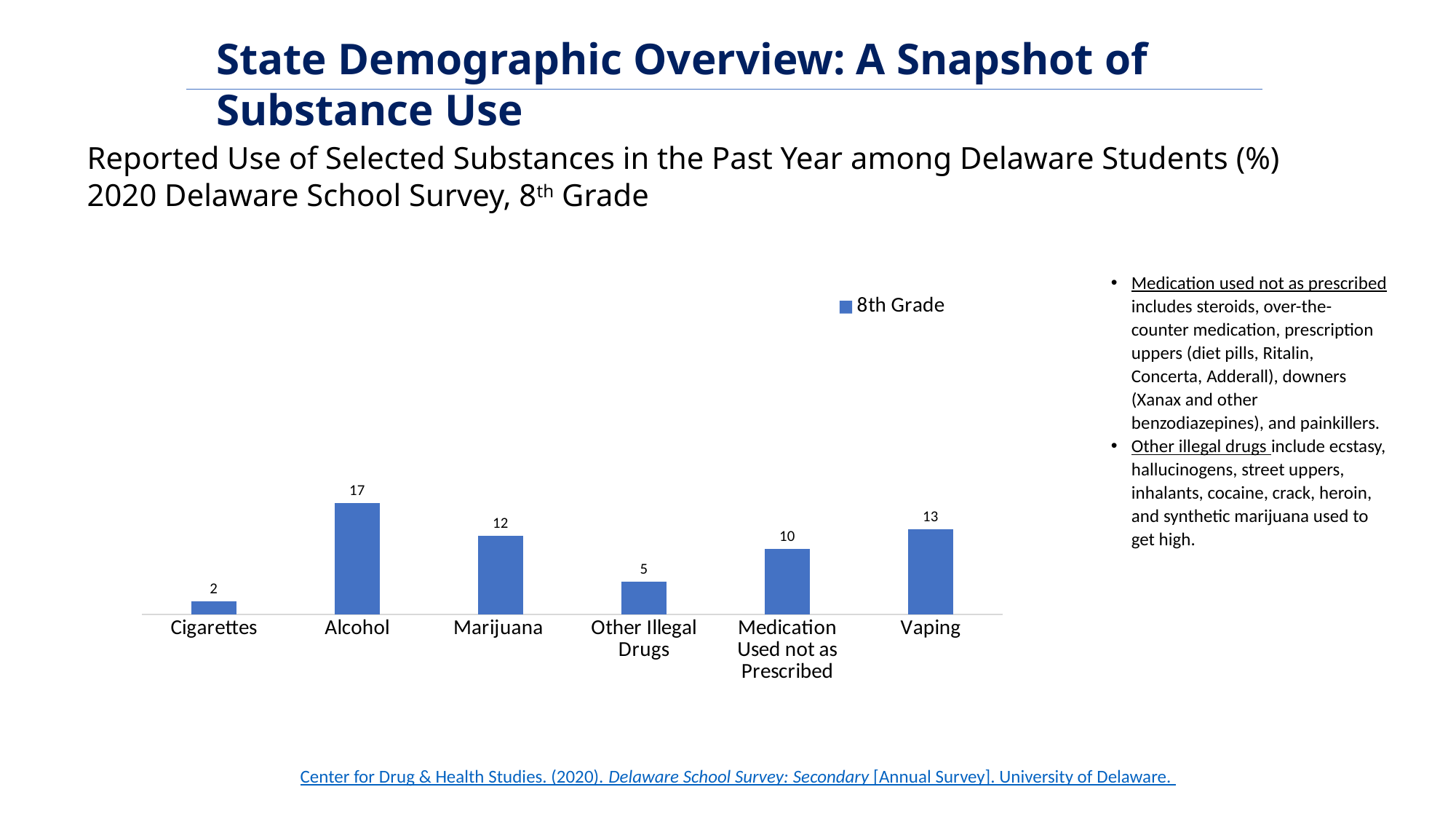
What is the difference between the values for Alcohol and Marijuana? 5 What is the value for Vaping? 13 What is the value for Alcohol? 17 What is the value for Cigarettes? 2 Which is larger, the value for Vaping or the value for Marijuana? Vaping What kind of chart is shown? Bar chart How many series does the legend list? 1 Which category has the lowest value? Cigarettes What is the value for Medication Used not as Prescribed? 10 How many categories are shown on the x axis? 6 What series name appears in the legend? 8th Grade Which category has the highest value? Alcohol